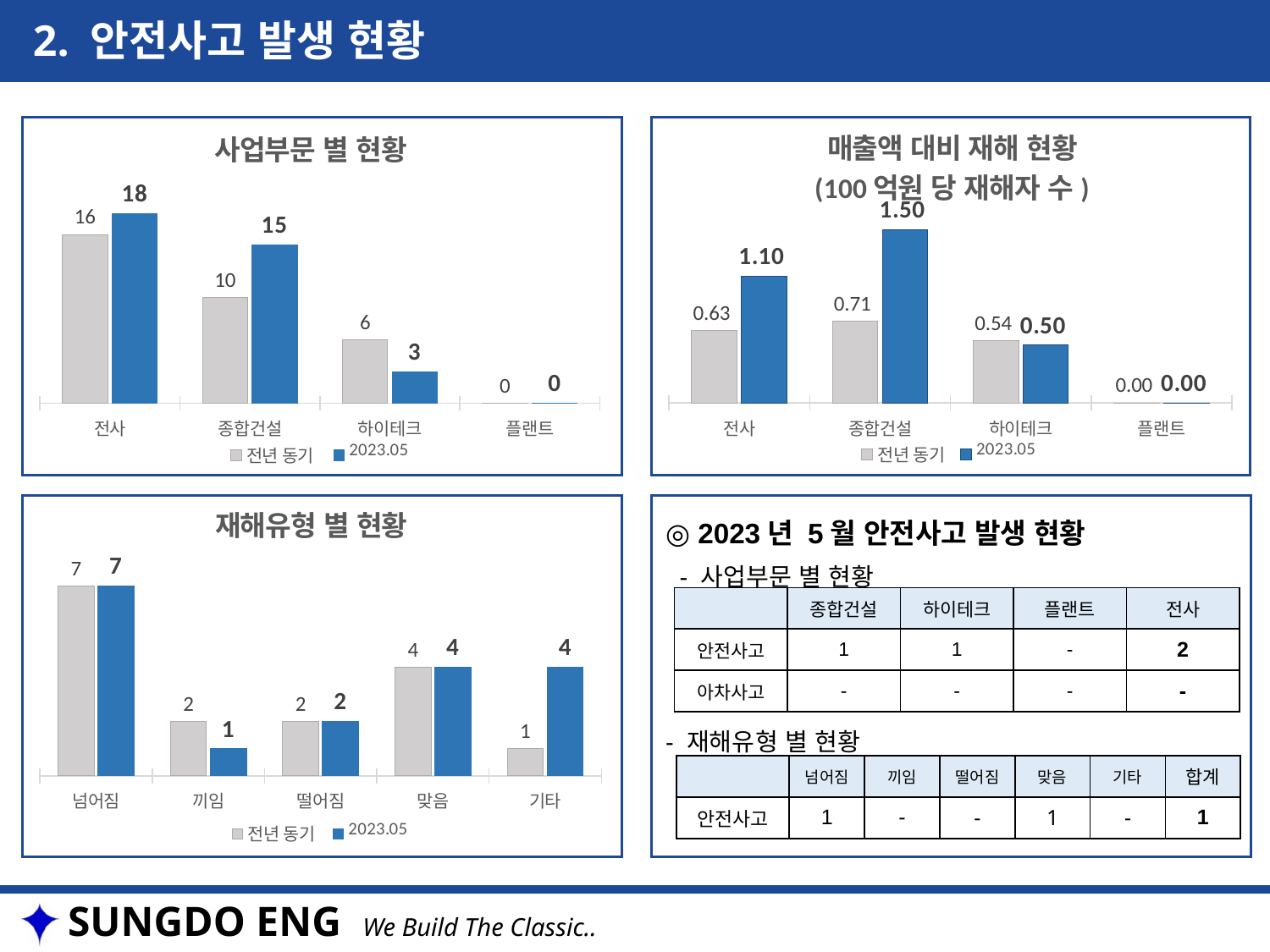
In the '매출액 대비 재해 현황' chart, how many series does the legend list? 2 In the '매출액 대비 재해 현황' chart, what is the 2023.05 value for 종합건설? 1.50 In the '사업부문 별 현황' chart, what is the 전년 동기 value for 하이테크? 6 In the '사업부문 별 현황' chart, what is the difference between the 2023.05 and 전년 동기 values for 전사? 2 In the '매출액 대비 재해 현황' chart, what is the 전년 동기 value for 전사? 0.63 In the '사업부문 별 현황' chart, what is the 2023.05 value for 종합건설? 15 In the '재해유형 별 현황' chart, how many categories are shown on the x axis? 5 In the '매출액 대비 재해 현황' chart, which is larger for 하이테크: the 전년 동기 value or the 2023.05 value? 전년 동기 In the '재해유형 별 현황' chart, what is the 2023.05 value for 기타? 4 What kind of chart is the '재해유형 별 현황' chart? bar chart In the '재해유형 별 현황' chart, which category has the highest 전년 동기 value? 넘어짐 In the '사업부문 별 현황' chart, which category has the highest 2023.05 value? 전사